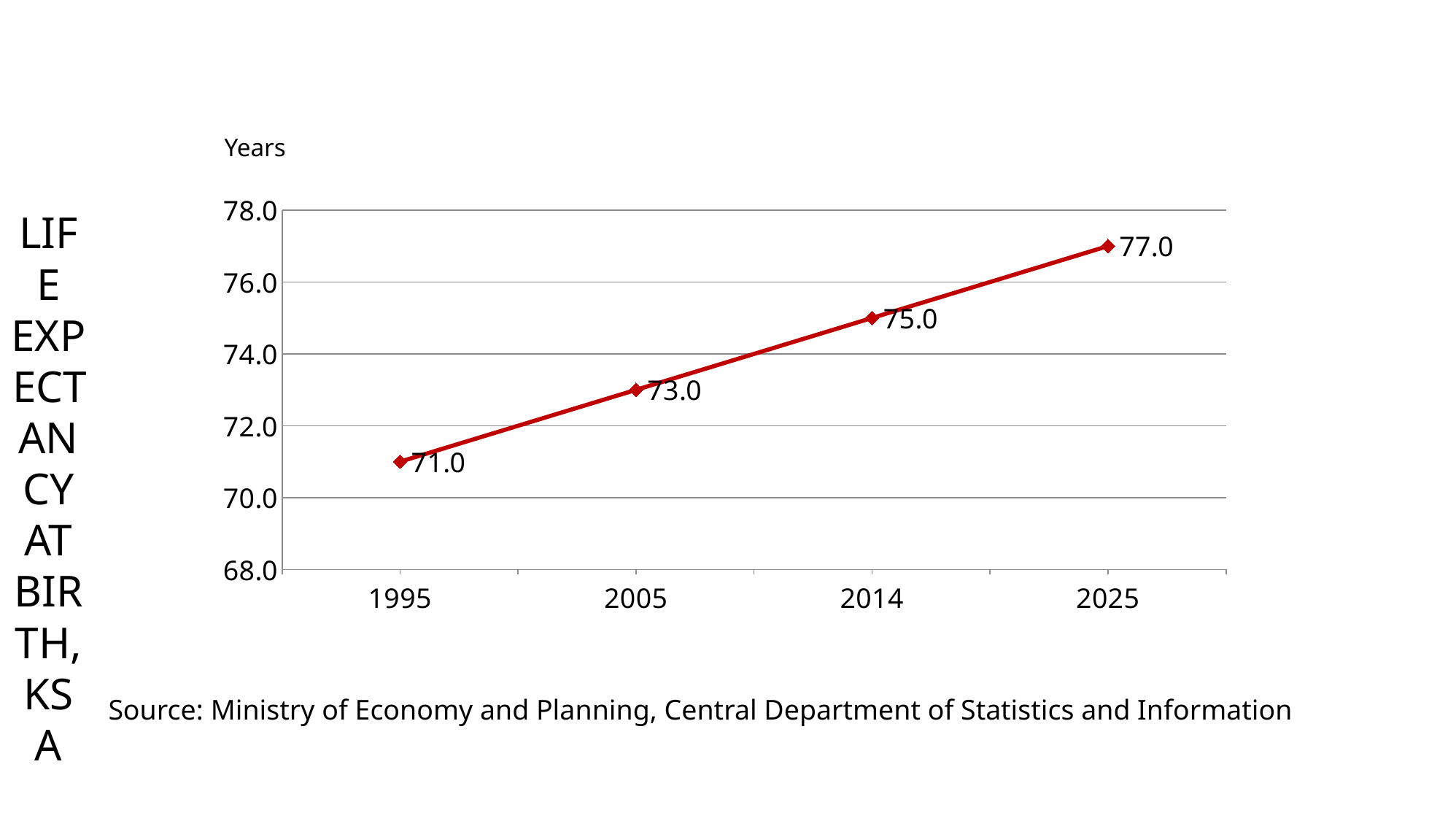
Do the values rise or fall from 1995 to 2025? rise Is the value for 2014 greater or less than 74.0? greater What is the difference between the life expectancy values for 2025 and 1995? 6.0 Which year has the lowest life expectancy value on the chart? 1995 What is the life expectancy value shown for 1995? 71.0 What is the life expectancy value shown for 2025? 77.0 What is the life expectancy value shown for 2005? 73.0 What kind of chart is shown on the slide? line chart Which is larger, the value for 2005 or the value for 2014? 2014 How many data points are plotted on the chart? 4 Which year has the highest life expectancy value on the chart? 2025 What is the life expectancy value shown for 2014? 75.0